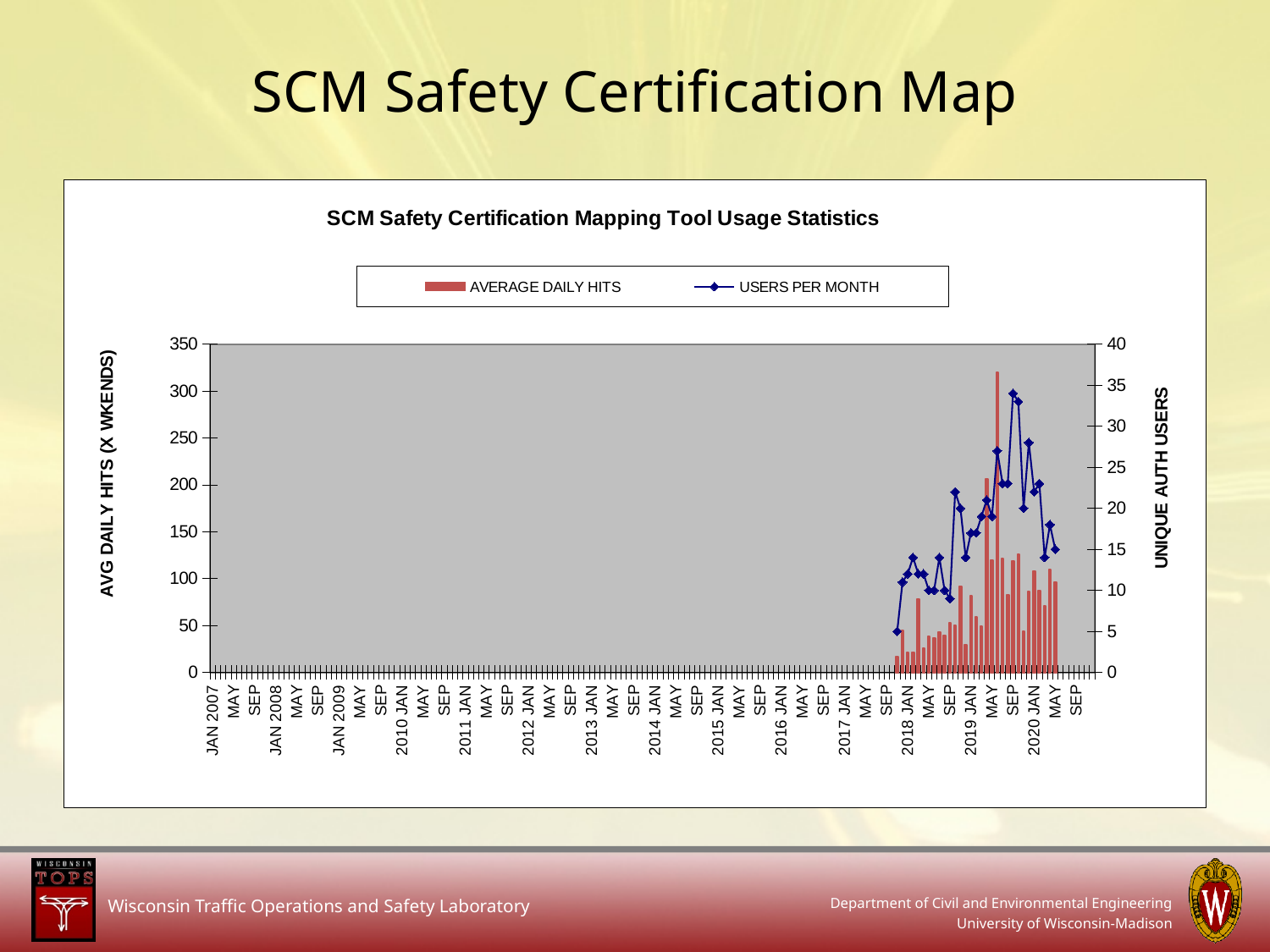
What is the maximum value shown on the left axis (AVG DAILY HITS)? 350 What is the maximum value shown on the right axis (UNIQUE AUTH USERS)? 40 Is the highest USERS PER MONTH value greater or less than 30? greater Do the USERS PER MONTH values generally rise or fall from SEP 2017 to SEP 2019? rise What kind of chart is shown on the slide? Combination bar and line chart How many series does the legend list? 2 What is the title of the chart? SCM Safety Certification Mapping Tool Usage Statistics Is the AVERAGE DAILY HITS value for JAN 2018 greater or less than 50? less Is the tallest AVERAGE DAILY HITS bar greater or less than 300? greater Which series is plotted as a line with diamond markers? USERS PER MONTH